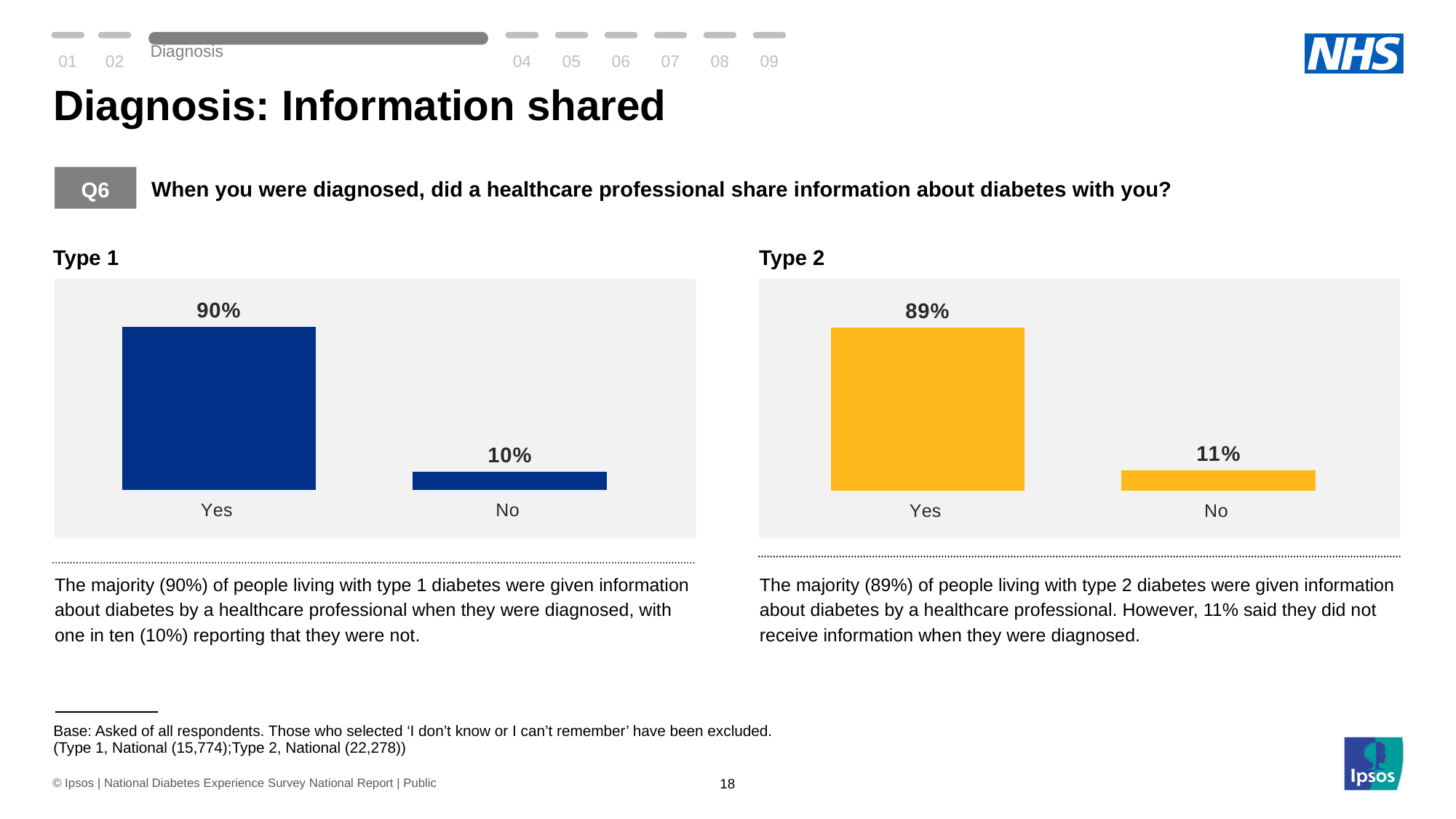
In the Type 2 chart, what percentage answered No? 11% In the Type 1 chart, what is the difference between the Yes and No values? 80% In the Type 1 chart, what percentage answered Yes? 90% In the Type 2 chart, what is the difference between the Yes and No values? 78% How many categories are shown in the Type 2 chart? 2 What colour are the bars in the Type 2 chart? Yellow In the Type 2 chart, what percentage answered Yes? 89% In the Type 1 chart, which category has the highest value? Yes What kind of chart is the Type 1 chart? Bar chart Which is larger: the Yes value in the Type 1 chart or the Yes value in the Type 2 chart? Type 1 In the Type 1 chart, what percentage answered No? 10% In the Type 2 chart, which category has the lowest value? No